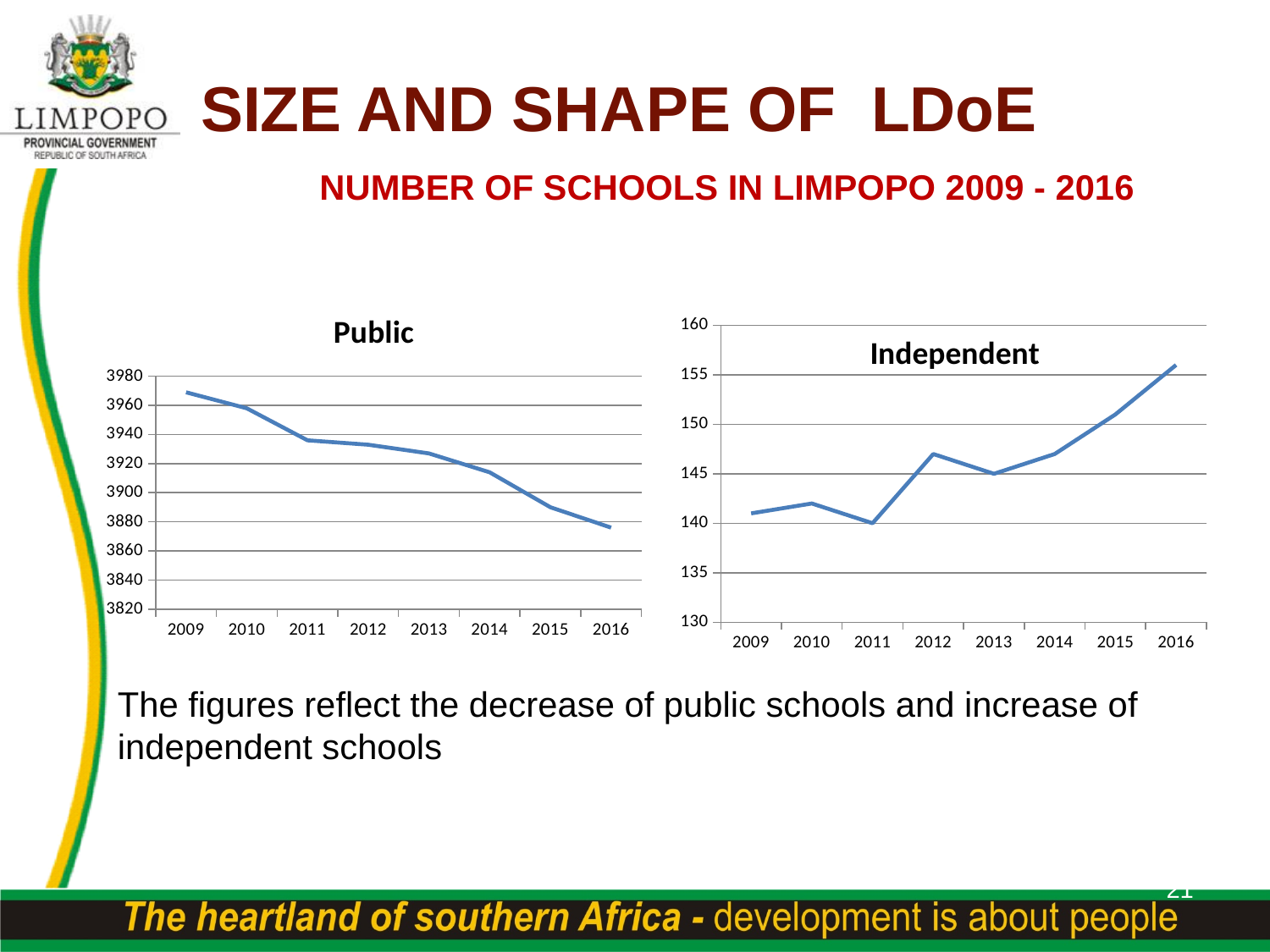
In the Public chart, is the value for 2016 greater or less than 3880? less In the Independent chart, is the value for 2016 greater or less than 155? greater In the Independent chart, which year has the highest number of schools? 2016 Do the values in the Public chart rise or fall from 2009 to 2016? fall In the Public chart, is the value for 2009 greater or less than 3960? greater How many years are plotted on the Independent chart? 8 In the Independent chart, which year has the lowest number of schools? 2011 In the Public chart, which year has the highest number of schools? 2009 What kind of chart is the Public chart? line chart In the Independent chart, which is larger, the value for 2012 or the value for 2013? 2012 In the Public chart, which year has the lowest number of schools? 2016 In the Independent chart, what is the value for 2011? 140